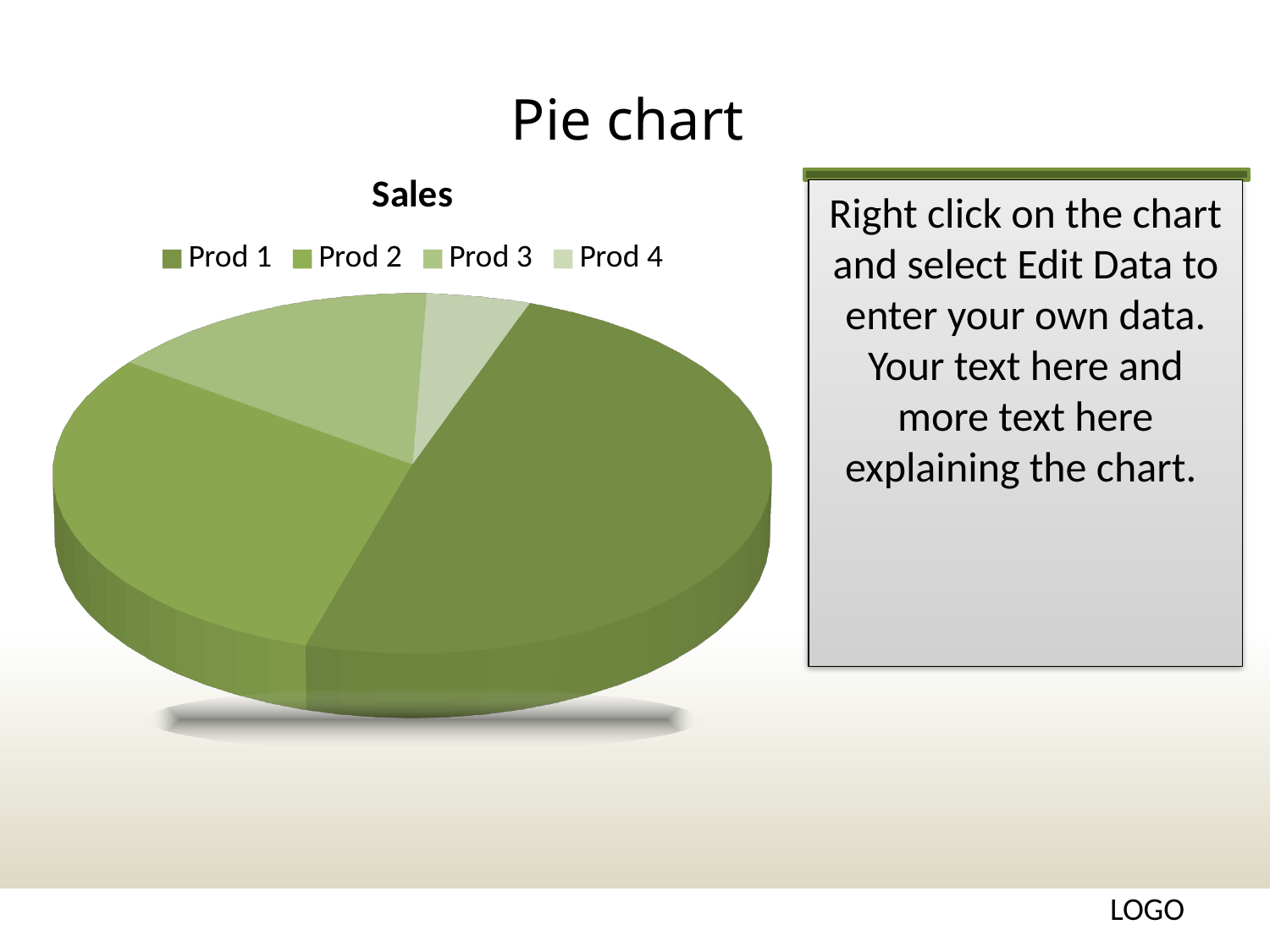
Which slice is larger, Prod 2 or Prod 3? Prod 2 What is the title of the chart? Sales What is the first entry listed in the chart legend? Prod 1 Which slice is smaller, Prod 1 or Prod 4? Prod 4 Which product has the largest slice of the pie? Prod 1 What kind of chart is shown on the slide? Pie chart How many slices does the pie chart have? 4 How many entries does the chart legend list? 4 Which slice is larger, Prod 1 or Prod 2? Prod 1 Which product has the smallest slice of the pie? Prod 4